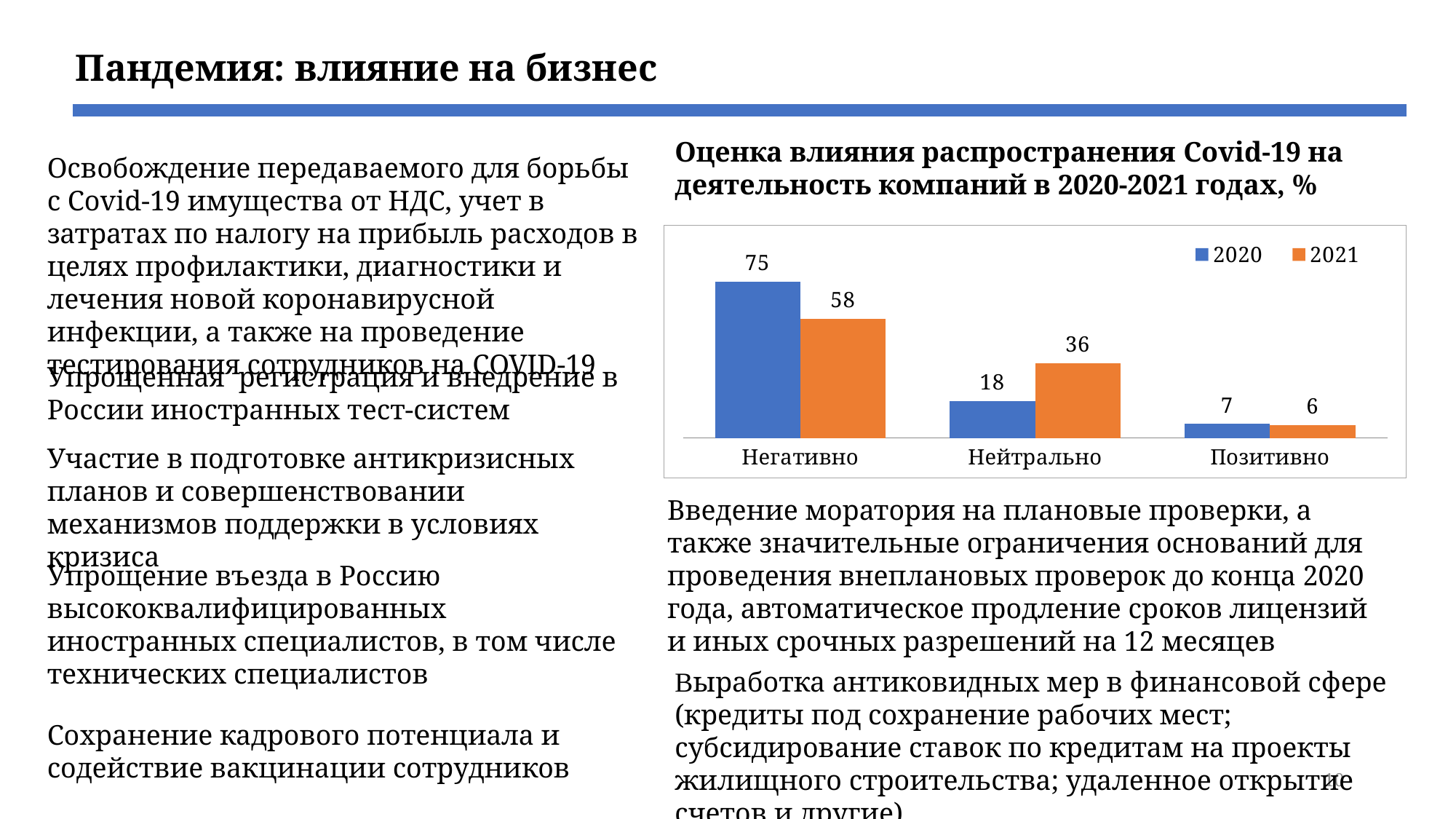
What is the difference between the 2020 and 2021 values in the Негативно category? 17 What is the value for 2021 in the Позитивно category? 6 What is the difference between the 2021 and 2020 values in the Нейтрально category? 18 What is the value for 2021 in the Нейтрально category? 36 What kind of chart is shown on the slide? Bar chart Which is larger in the Нейтрально category, the 2020 value or the 2021 value? 2021 What is the value for 2020 in the Негативно category? 75 Which category has the highest value for 2020? Негативно What is the title of the chart? Оценка влияния распространения Covid-19 на деятельность компаний в 2020-2021 годах, % How many series does the legend list? 2 Which category has the lowest value for 2021? Позитивно How many categories are shown on the x axis? 3